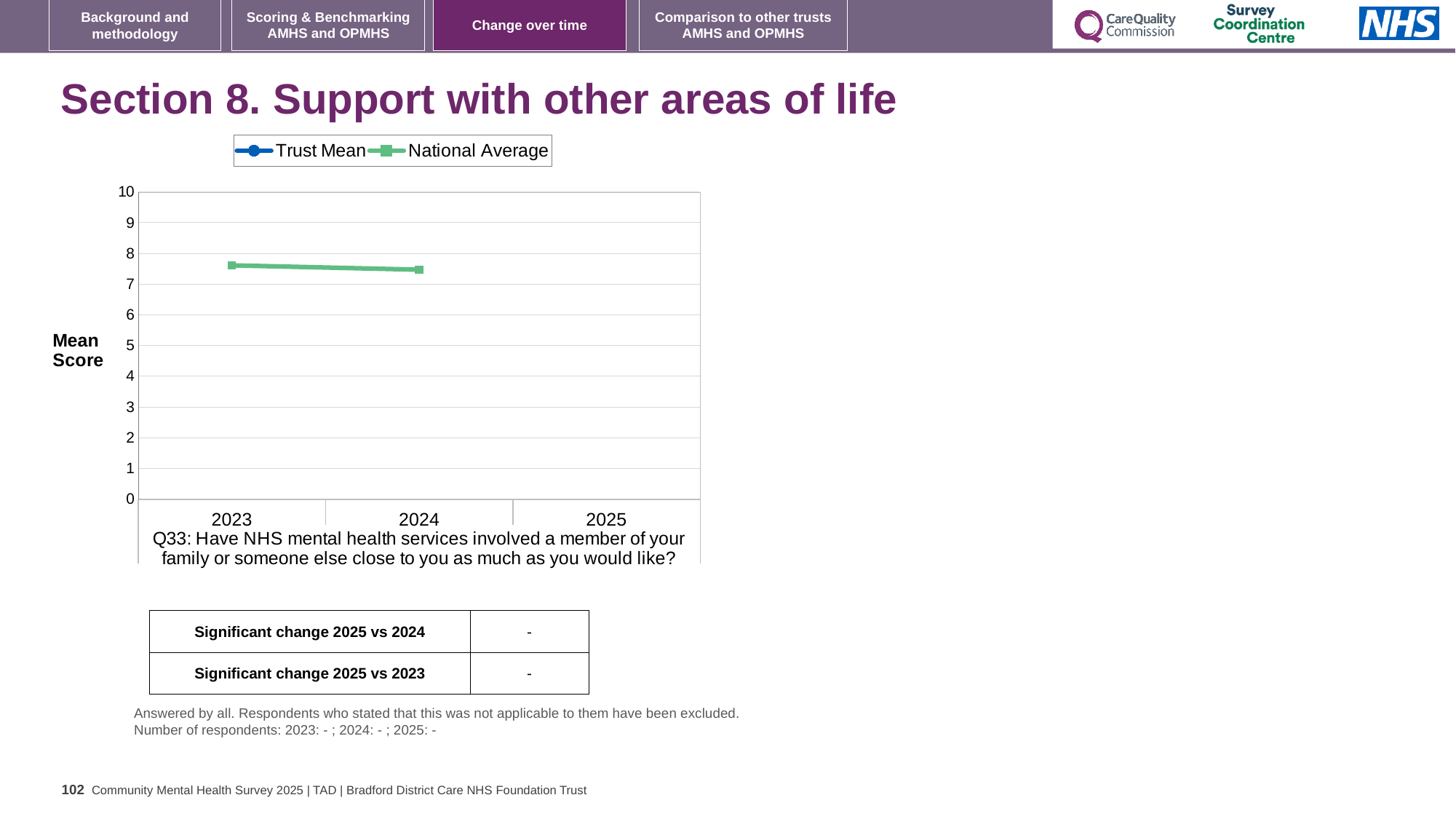
What is the maximum value shown on the y axis of the chart? 10 Is the National Average value for 2023 greater or less than 8? less Is the National Average value for 2024 greater or less than 7? greater How many years are shown on the x axis of the chart? 3 Which years are shown on the x axis of the chart? 2023, 2024, 2025 What are the two series named in the chart legend? Trust Mean and National Average Is the National Average value for 2023 greater or less than 7? greater How many series does the chart legend list? 2 Does the National Average line rise or fall from 2023 to 2024? fall What kind of chart is shown on the slide? line chart